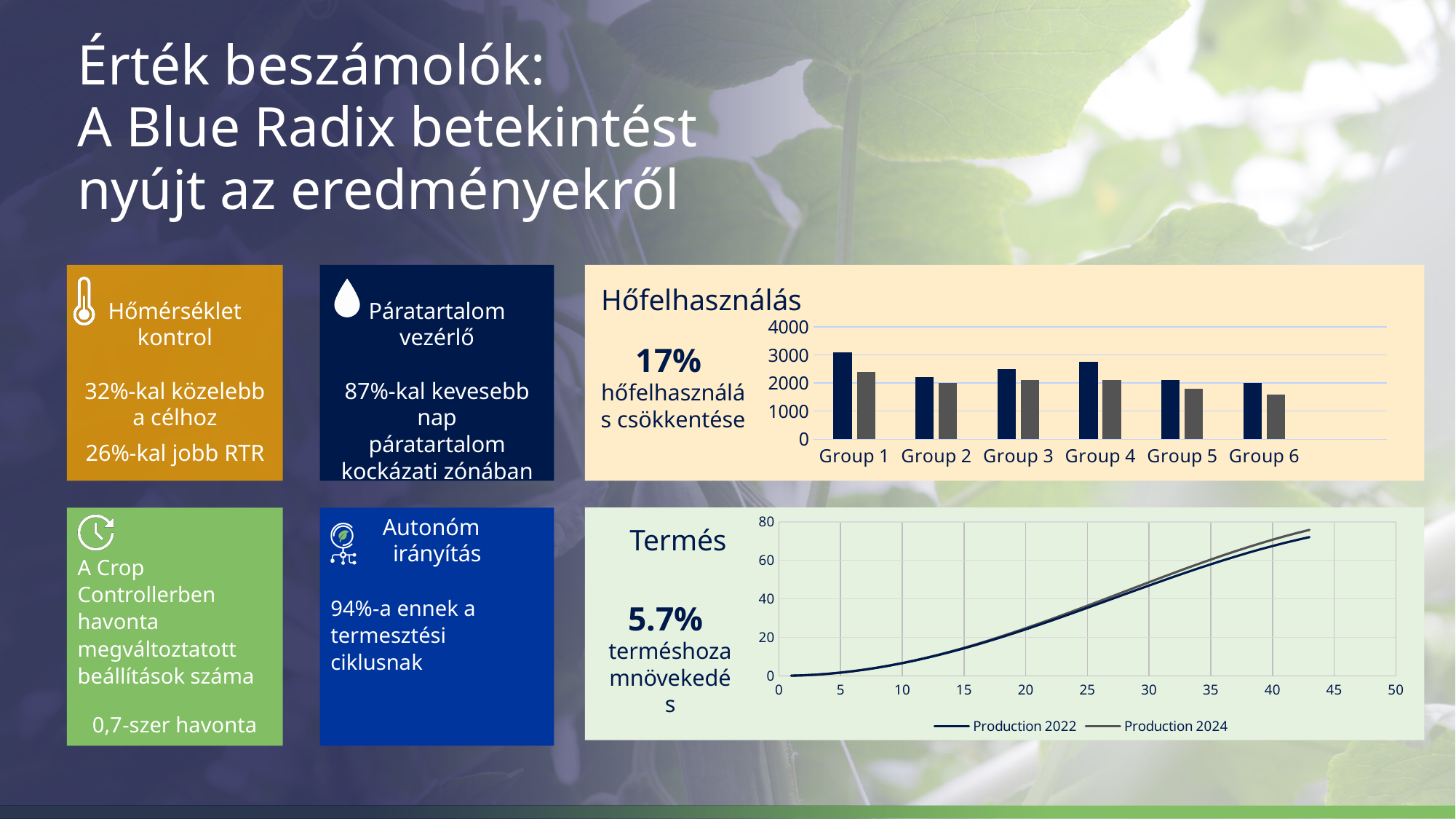
On the Termés chart, do the lines rise or fall as the x axis increases? rise On the Hőfelhasználás chart, how many groups are shown on the x axis? 6 On the Termés chart, is the Production 2024 value at x = 40 greater or less than 60? greater On the Hőfelhasználás chart, which group has the tallest dark blue bar? Group 1 On the Hőfelhasználás chart, is the gray bar for Group 6 greater or less than 2000? less On the Hőfelhasználás chart, what kind of chart is shown? bar chart On the Termés chart, what kind of chart is shown? line chart On the Hőfelhasználás chart, is the dark blue bar for Group 1 greater or less than 2000? greater On the Termés chart, what are the two legend entries? Production 2022 and Production 2024 On the Hőfelhasználás chart, which group has the shortest gray bar? Group 6 On the Termés chart, how many series does the legend list? 2 On the Hőfelhasználás chart, in Group 1, which bar is taller, the dark blue bar or the gray bar? the dark blue bar